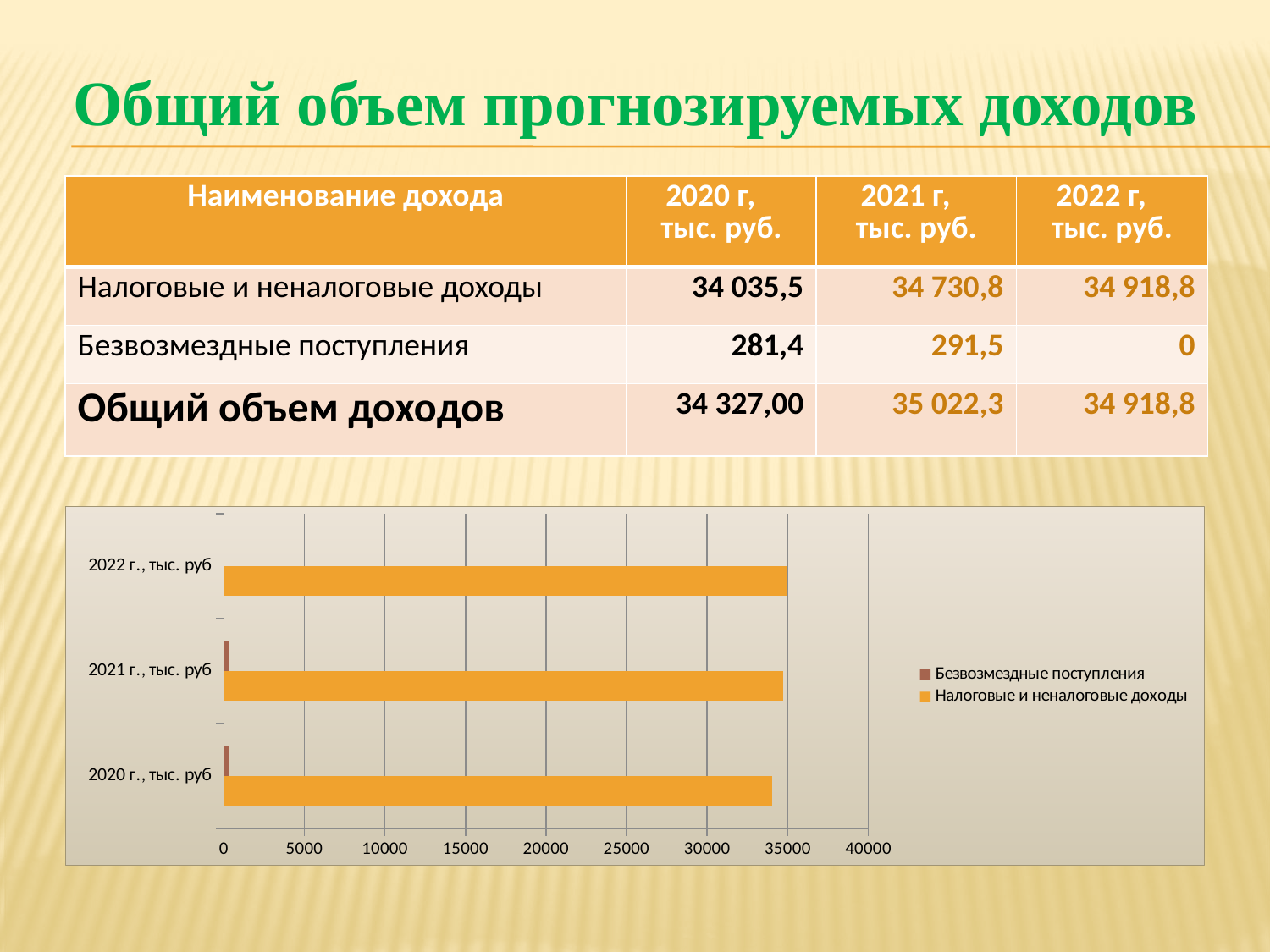
In 2020 г., which series has the larger value: Безвозмездные поступления or Налоговые и неналоговые доходы? Налоговые и неналоговые доходы What is the highest value labelled on the chart's horizontal axis? 40000 Is the value for Налоговые и неналоговые доходы in 2020 г. greater or less than 35000? less What kind of chart is shown on the slide? bar chart Is the value for Безвозмездные поступления in 2021 г. greater or less than 5000? less How many series does the chart legend list? 2 Is the value for Налоговые и неналоговые доходы in 2021 г. greater or less than 25000? greater Which series is shown in orange in the chart legend? Налоговые и неналоговые доходы How many categories (years) are shown on the chart's vertical axis? 3